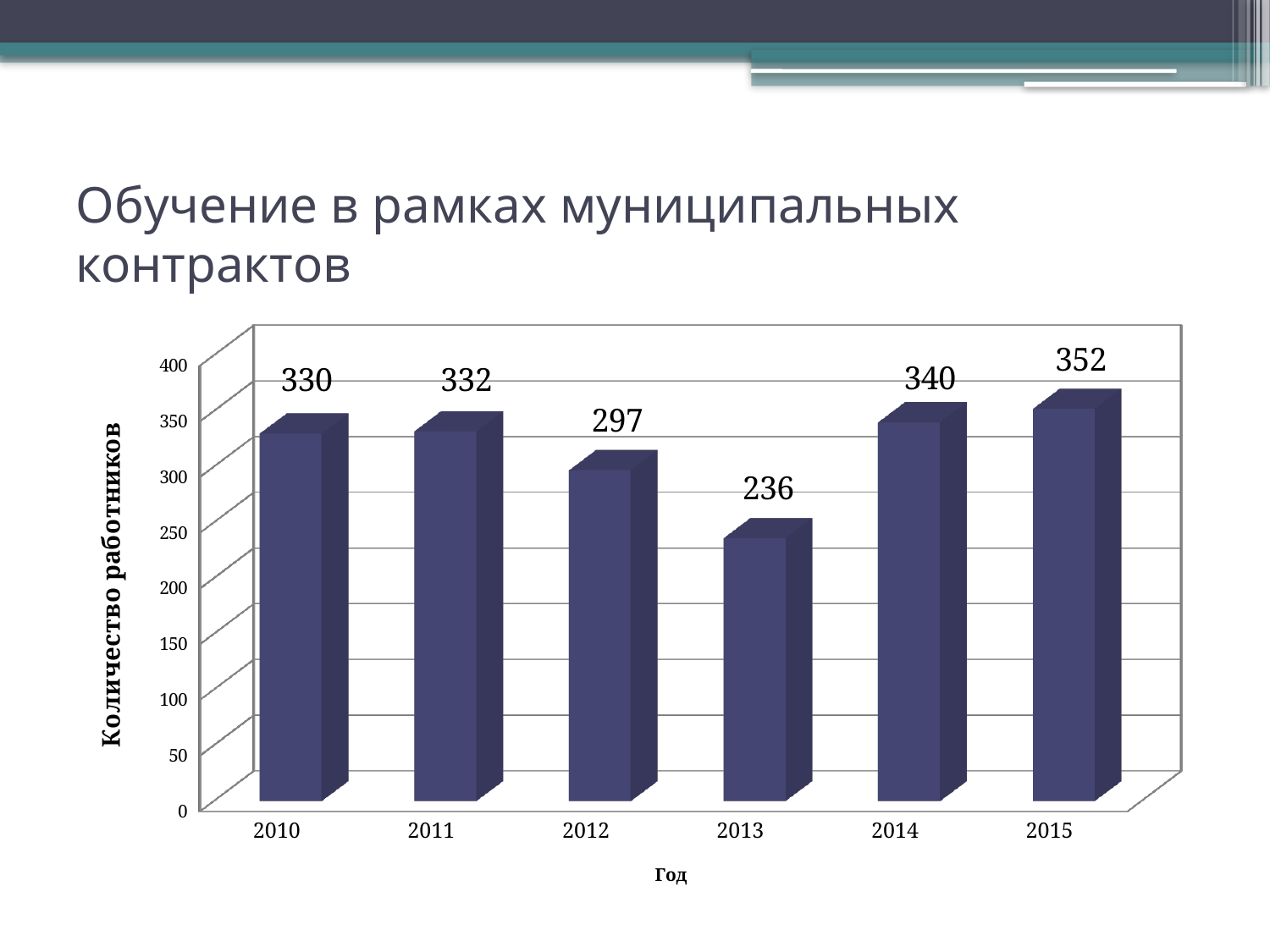
What is the difference between the values for 2015 and 2013? 116 Is the value for 2013 greater or less than 250? less What kind of chart is shown on the slide? bar chart How many years are shown on the x axis? 6 Which is larger, the value for 2010 or the value for 2014? 2014 Which year has the highest value? 2015 What is the value for 2015? 352 What is the value for 2012? 297 What is the label of the vertical axis? Количество работников Which year has the lowest value? 2013 What is the value for 2013? 236 What is the difference between the values for 2014 and 2012? 43